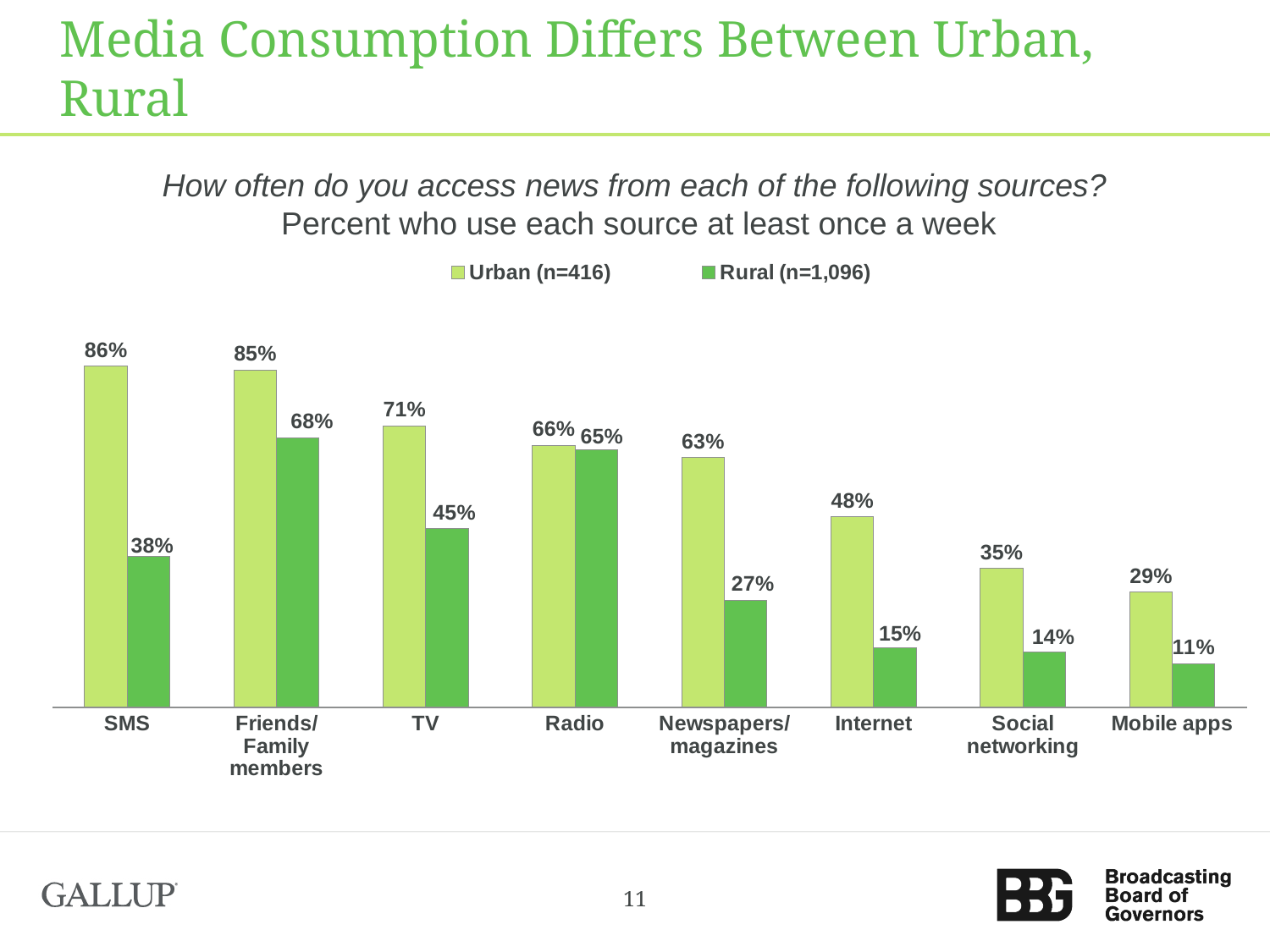
What is the Rural value for TV? 45% What is the difference between the Urban and Rural values for SMS? 48 percentage points What percentage of urban respondents use SMS for news at least once a week? 86% What is the Rural value for Mobile apps? 11% What is the difference between the Urban and Rural values for Internet? 33 percentage points How many news sources are shown on the x axis? 8 How many series does the legend list? 2 Which source has the highest Rural value? Friends/Family members What is the sample size for the Rural group shown in the legend? n=1,096 Which source has the lowest Urban value? Mobile apps What kind of chart is shown on the slide? Bar chart Which is larger for Newspapers/magazines, the Urban value or the Rural value? Urban